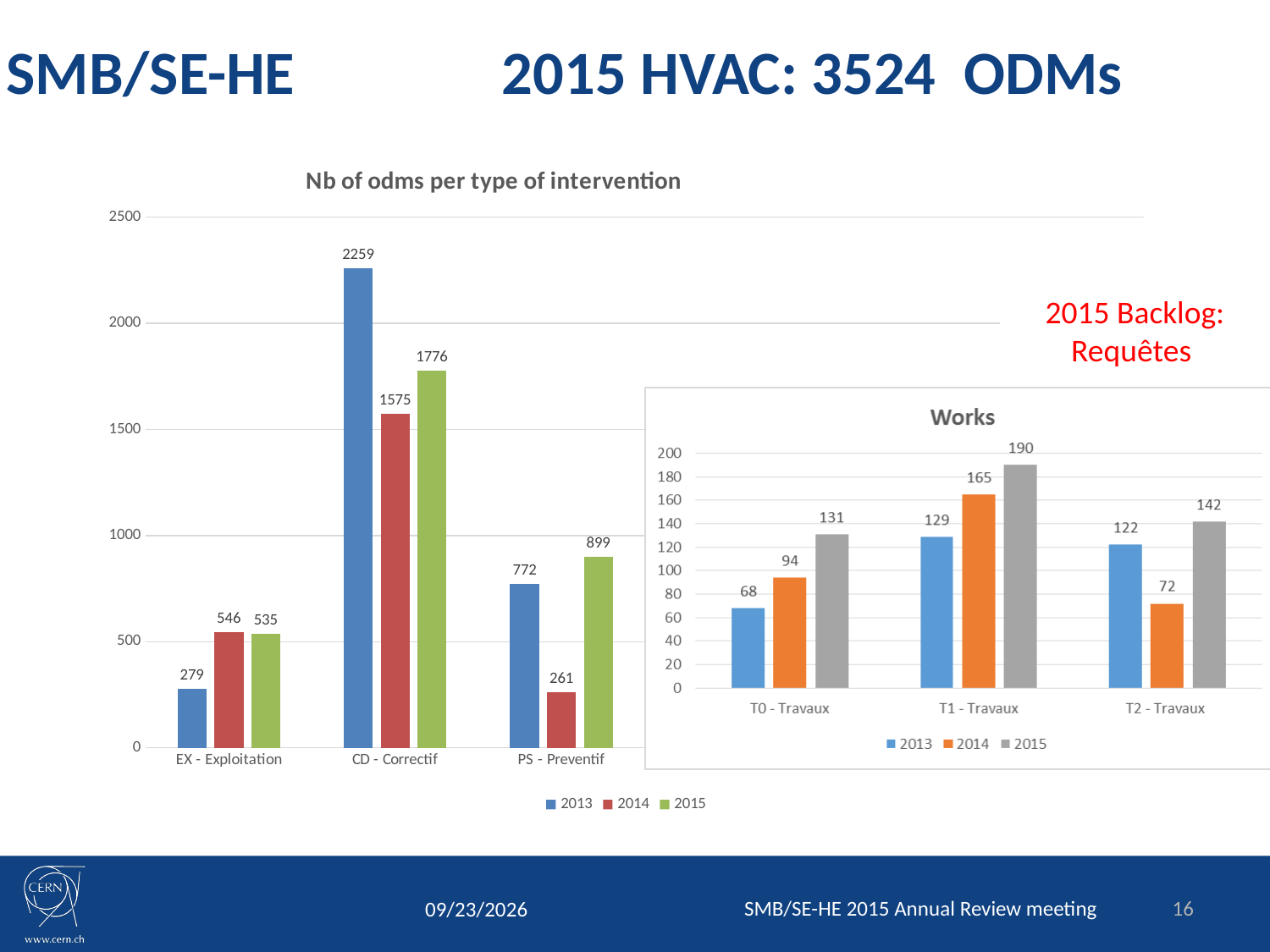
In the 'Works' chart, how many categories are shown on the x axis? 3 In the 'Works' chart, which category has the lowest 2014 value? T2 - Travaux In the 'Works' chart, what is the difference between the 2015 and 2014 values for T0 - Travaux? 37 In the 'Nb of odms per type of intervention' chart, what is the value for PS - Preventif in 2014? 261 In the 'Works' chart, what is the value for T0 - Travaux in 2013? 68 In the 'Nb of odms per type of intervention' chart, which category has the highest 2015 value? CD - Correctif What kind of chart is the 'Works' chart? Bar chart In the 'Nb of odms per type of intervention' chart, which is larger for EX - Exploitation: the 2014 value or the 2015 value? 2014 In the 'Works' chart, what is the value for T1 - Travaux in 2015? 190 In the 'Nb of odms per type of intervention' chart, what is the value for CD - Correctif in 2013? 2259 In the 'Nb of odms per type of intervention' chart, how many series does the legend list? 3 In the 'Nb of odms per type of intervention' chart, what is the difference between the 2013 and 2014 values for CD - Correctif? 684